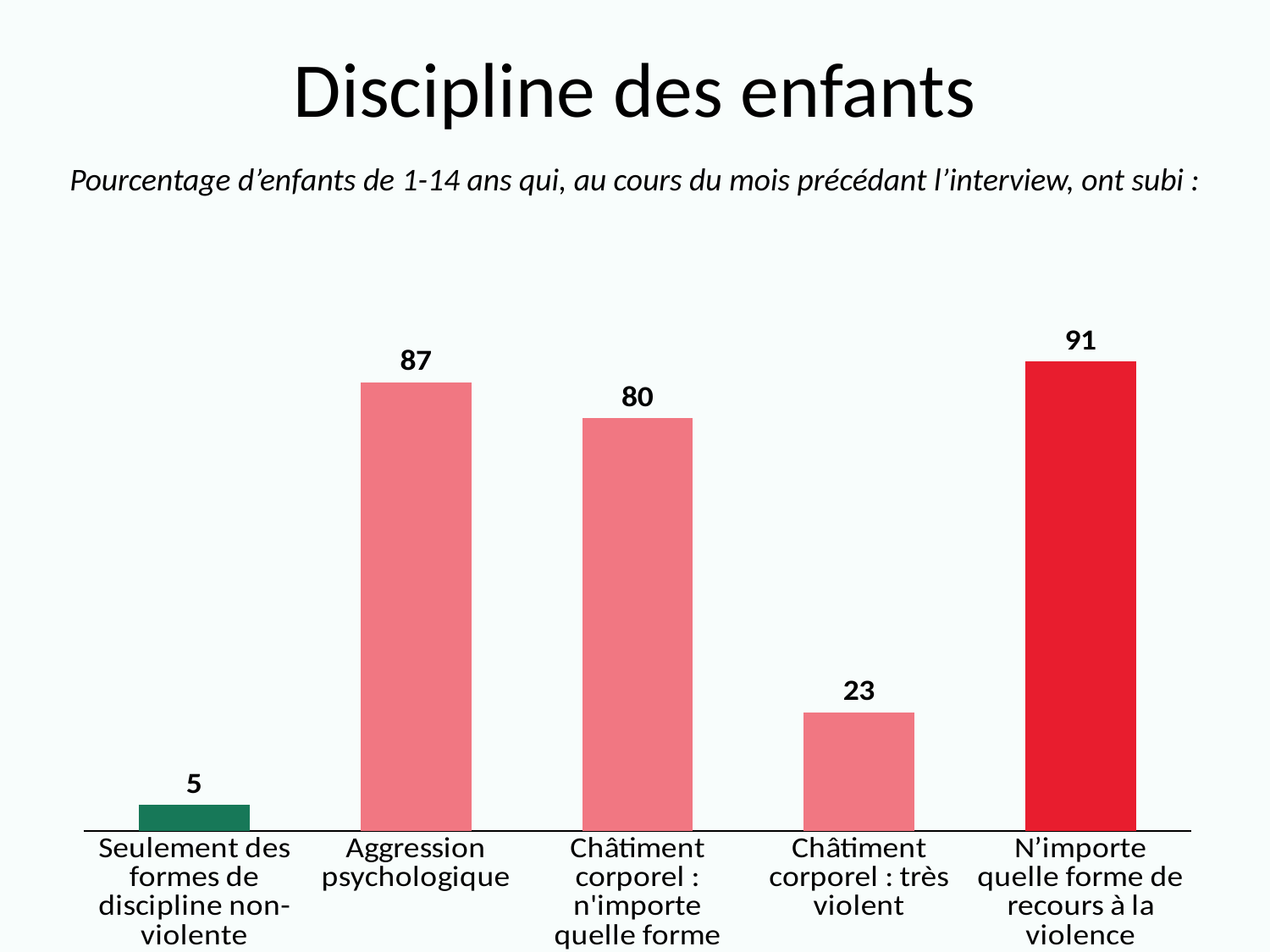
Which category has the lowest value? Seulement des formes de discipline non-violente Which category has the highest value? N'importe quelle forme de recours à la violence What is the value for "Châtiment corporel : très violent"? 23 What kind of chart is shown on the slide? Bar chart What is the value for "N'importe quelle forme de recours à la violence"? 91 What is the value for "Aggression psychologique"? 87 Which bar is coloured green? Seulement des formes de discipline non-violente What is the title of the slide? Discipline des enfants What is the difference between the values for "Aggression psychologique" and "Châtiment corporel : n'importe quelle forme"? 7 How many categories are shown in the chart? 5 What is the value for "Seulement des formes de discipline non-violente"? 5 Which is larger: the value for "Châtiment corporel : n'importe quelle forme" or the value for "Châtiment corporel : très violent"? Châtiment corporel : n'importe quelle forme